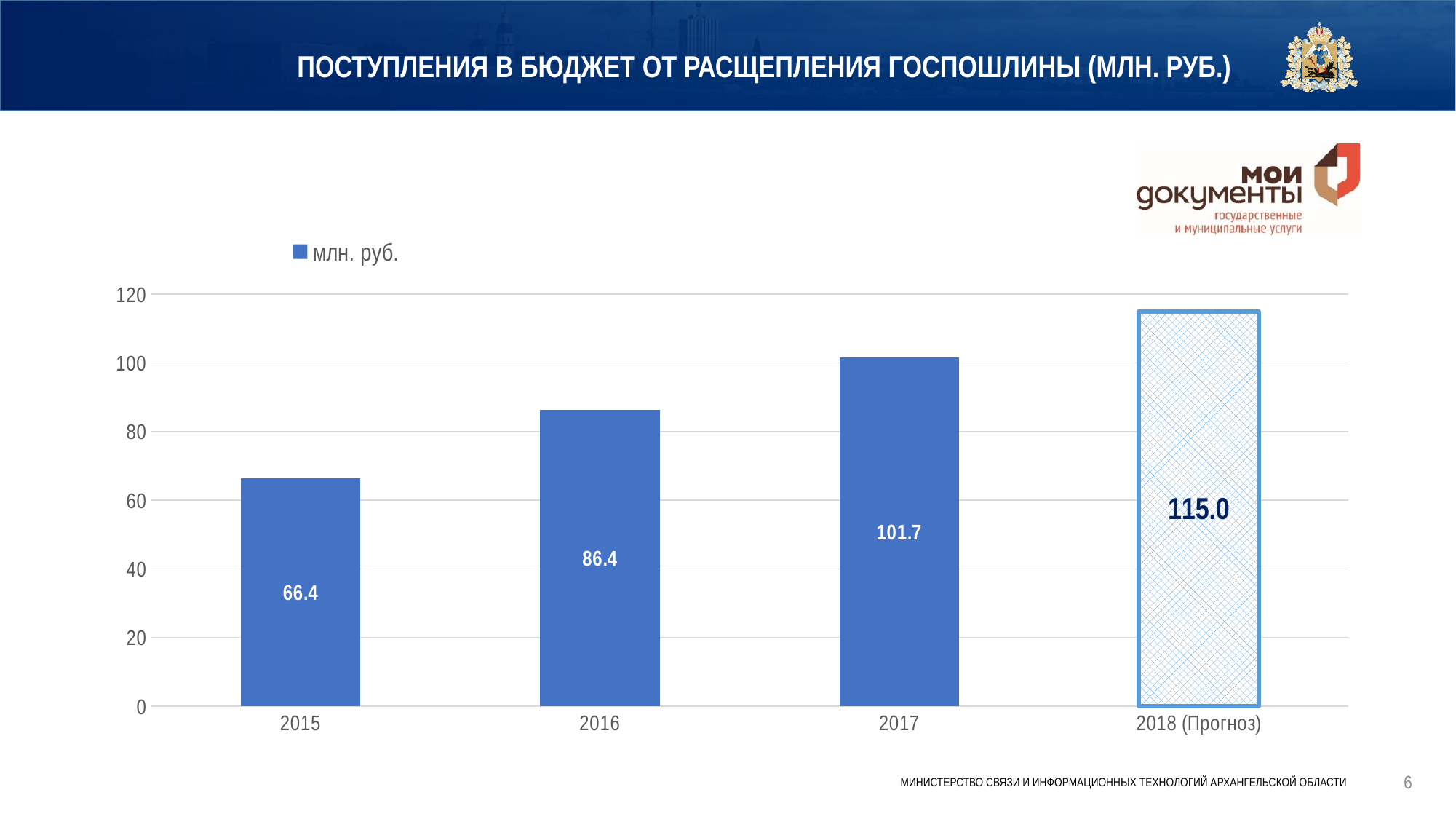
What is the difference between the values for 2017 and 2016? 15.3 What is the value for 2017? 101.7 Is the value for 2016 greater or less than 80? greater How many categories are shown on the x axis? 4 What is the forecast value for 2018 (Прогноз)? 115.0 What is the value for 2015? 66.4 Which category has the highest value? 2018 (Прогноз) Which category has the lowest value? 2015 What is the difference between the 2018 (Прогноз) value and the 2015 value? 48.6 Which is larger, the value for 2016 or the value for 2017? 2017 Do the values rise or fall from 2015 to 2018 (Прогноз)? Rise What kind of chart is shown on the slide? Bar chart